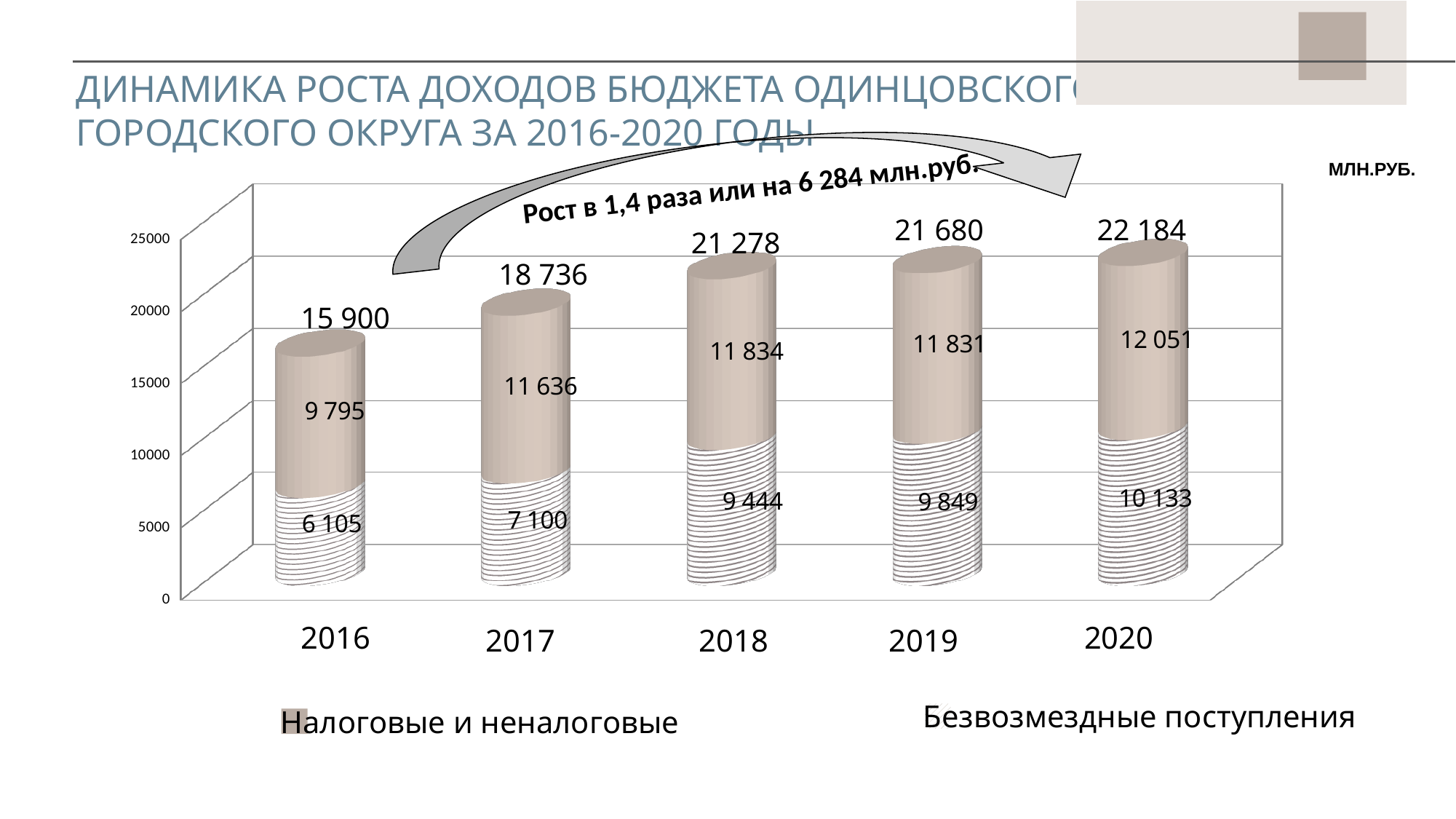
What is the total budget revenue shown for 2016? 15 900 What is the value of Безвозмездные поступления for 2020? 10 133 How many years are shown on the x axis? 5 Which year has the highest total budget revenue? 2020 What is the difference between the total for 2020 and the total for 2016? 6 284 How many series does the legend list? 2 What is the value of Налоговые и неналоговые for 2018? 11 834 What kind of chart is shown on the slide? Stacked bar chart Which year has the lowest value for Налоговые и неналоговые? 2016 Do the total budget revenues rise or fall from 2016 to 2020? Rise Which is larger in 2017: Налоговые и неналоговые or Безвозмездные поступления? Налоговые и неналоговые What unit of measurement is indicated for the chart values? МЛН.РУБ.